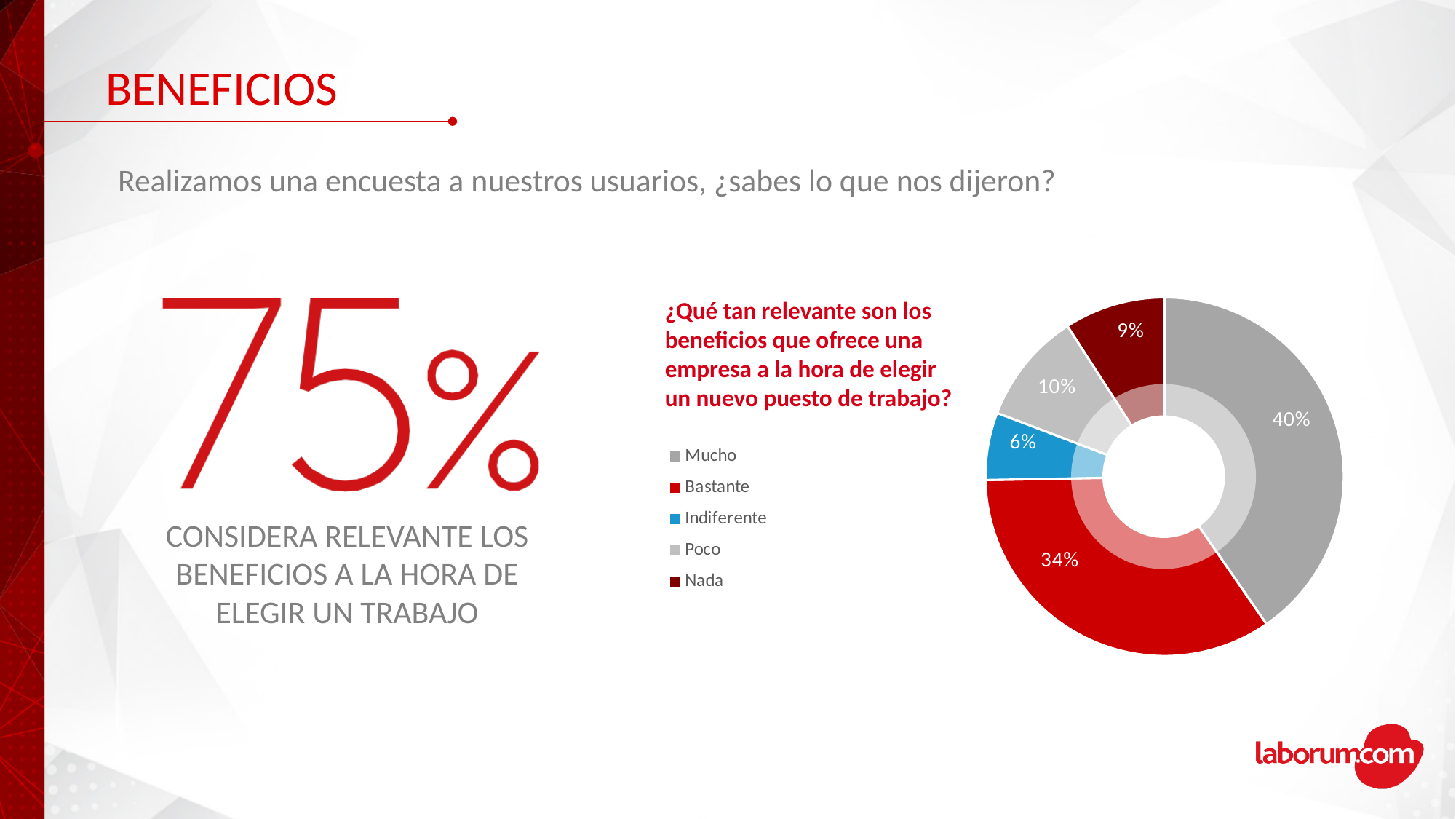
Which response category has the largest share of the chart? Mucho How many response categories does the chart show? 5 What percentage of respondents answered "Poco"? 10% Which is larger, the share for "Poco" or the share for "Nada"? Poco What kind of chart is shown on the slide? Doughnut chart What colour is the "Indiferente" segment in the chart? Blue What is the difference in percentage points between "Mucho" and "Bastante"? 6 What percentage of respondents answered "Mucho"? 40% Which response category has the smallest share of the chart? Indiferente What percentage of respondents answered "Indiferente"? 6% What percentage of respondents answered "Nada"? 9% What percentage of respondents answered "Bastante"? 34%